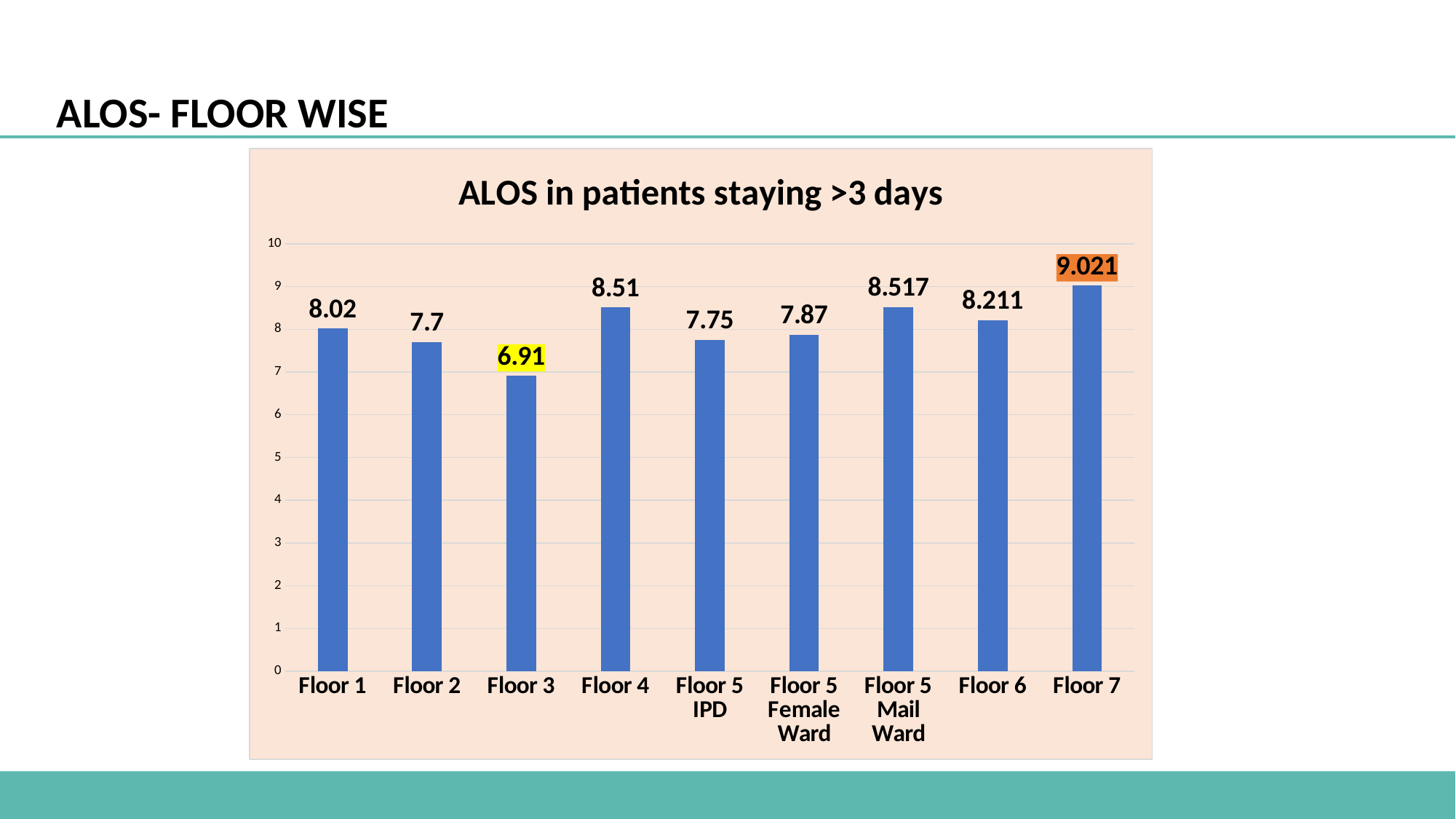
Which floor has the highest ALOS? Floor 7 What is the title of the chart? ALOS in patients staying >3 days What is the difference between the ALOS for Floor 4 and Floor 2? 0.81 How many floor categories are shown on the chart? 9 What is the difference between the ALOS for Floor 7 and Floor 3? 2.111 Is the value for Floor 7 greater or less than 9? greater What type of chart is shown on the slide? Bar chart Which has a higher ALOS, Floor 5 IPD or Floor 5 Mail Ward? Floor 5 Mail Ward What is the ALOS value for Floor 6? 8.211 What is the ALOS value for Floor 5 Female Ward? 7.87 Which floor has the lowest ALOS? Floor 3 What is the ALOS value for Floor 1? 8.02